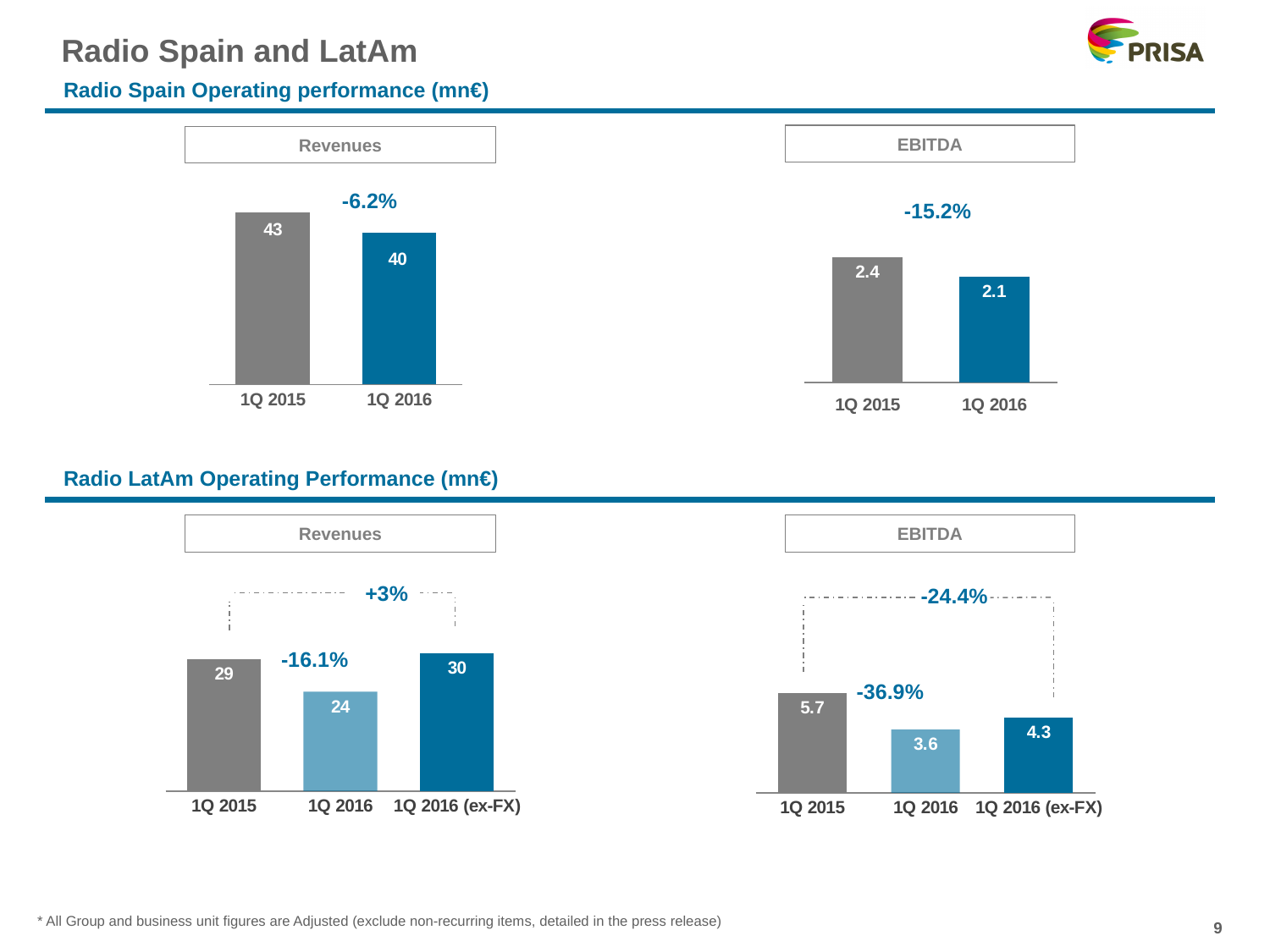
What type of chart is the Radio Spain Revenues chart? Bar chart In the Radio LatAm EBITDA chart, which category has the highest value? 1Q 2015 In the Radio Spain Revenues chart, what is the difference between the 1Q 2015 and 1Q 2016 values? 3 In the Radio LatAm EBITDA chart, what percentage change is shown between 1Q 2015 and 1Q 2016 (ex-FX)? -24.4% In the Radio Spain Revenues chart, what is the value for 1Q 2016? 40 In the Radio LatAm Revenues chart, how many categories are plotted? 3 In the Radio Spain EBITDA chart, what is the value for 1Q 2015? 2.4 In the Radio LatAm EBITDA chart, what is the difference between the 1Q 2015 and 1Q 2016 (ex-FX) values? 1.4 In the Radio Spain EBITDA chart, what percentage change is shown between 1Q 2015 and 1Q 2016? -15.2% In the Radio LatAm EBITDA chart, what is the value for 1Q 2016? 3.6 In the Radio LatAm Revenues chart, what is the value for 1Q 2016 (ex-FX)? 30 In the Radio LatAm Revenues chart, which category has the lowest value? 1Q 2016